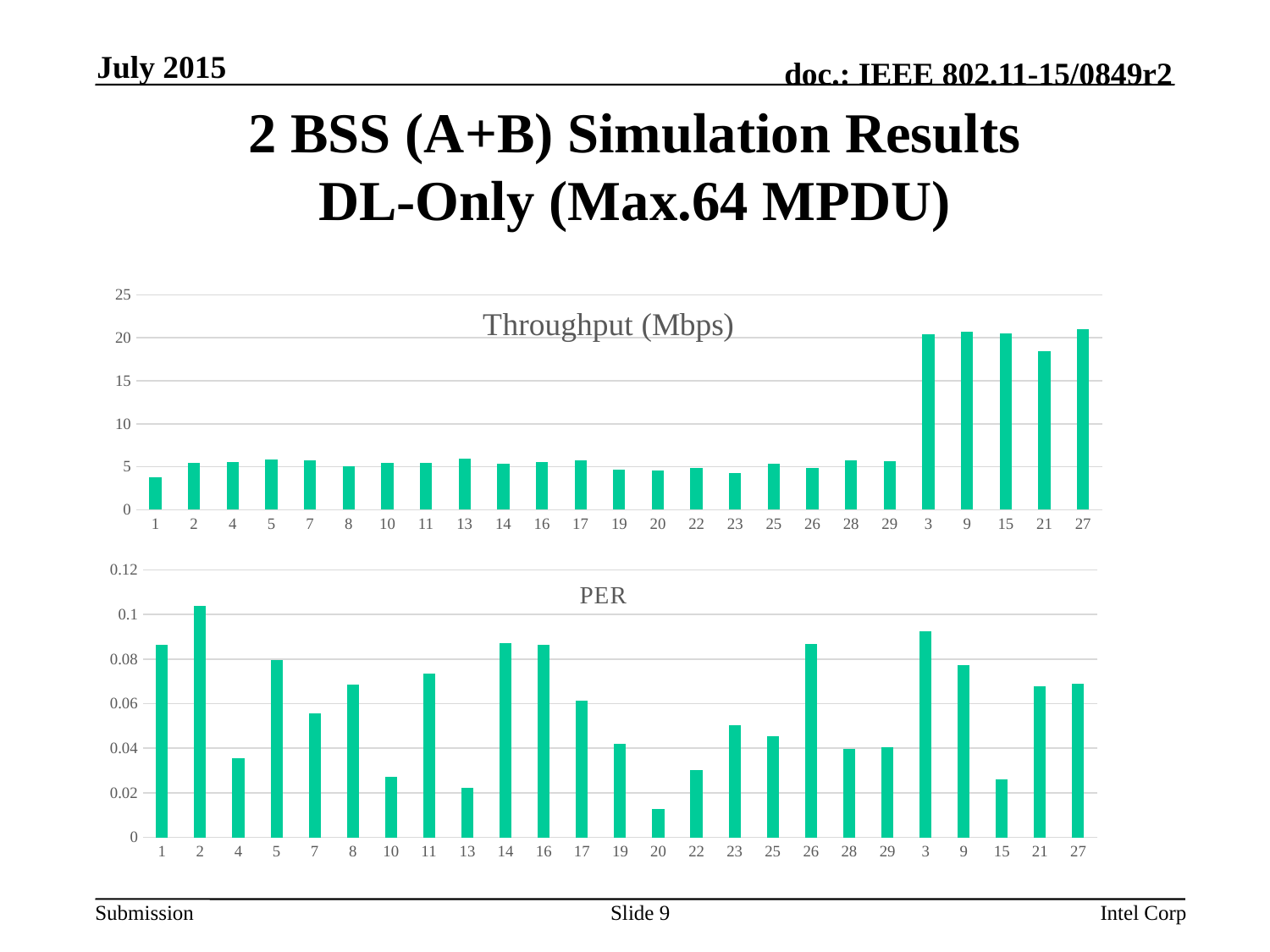
On the Throughput (Mbps) chart, is the value for category 21 greater or less than 20? less What kind of chart is the Throughput (Mbps) chart? bar chart On the Throughput (Mbps) chart, which category has the lowest value? 1 On the PER chart, is the value for category 20 greater or less than 0.02? less On the PER chart, which category has the lowest value? 20 What is the title of the lower chart on the slide? PER On the Throughput (Mbps) chart, is the value for category 1 greater or less than 5? less On the PER chart, which is larger, the value for category 10 or category 11? 11 How many categories are plotted on the PER chart? 25 On the Throughput (Mbps) chart, which is larger, the value for category 21 or category 27? 27 On the PER chart, which category has the highest value? 2